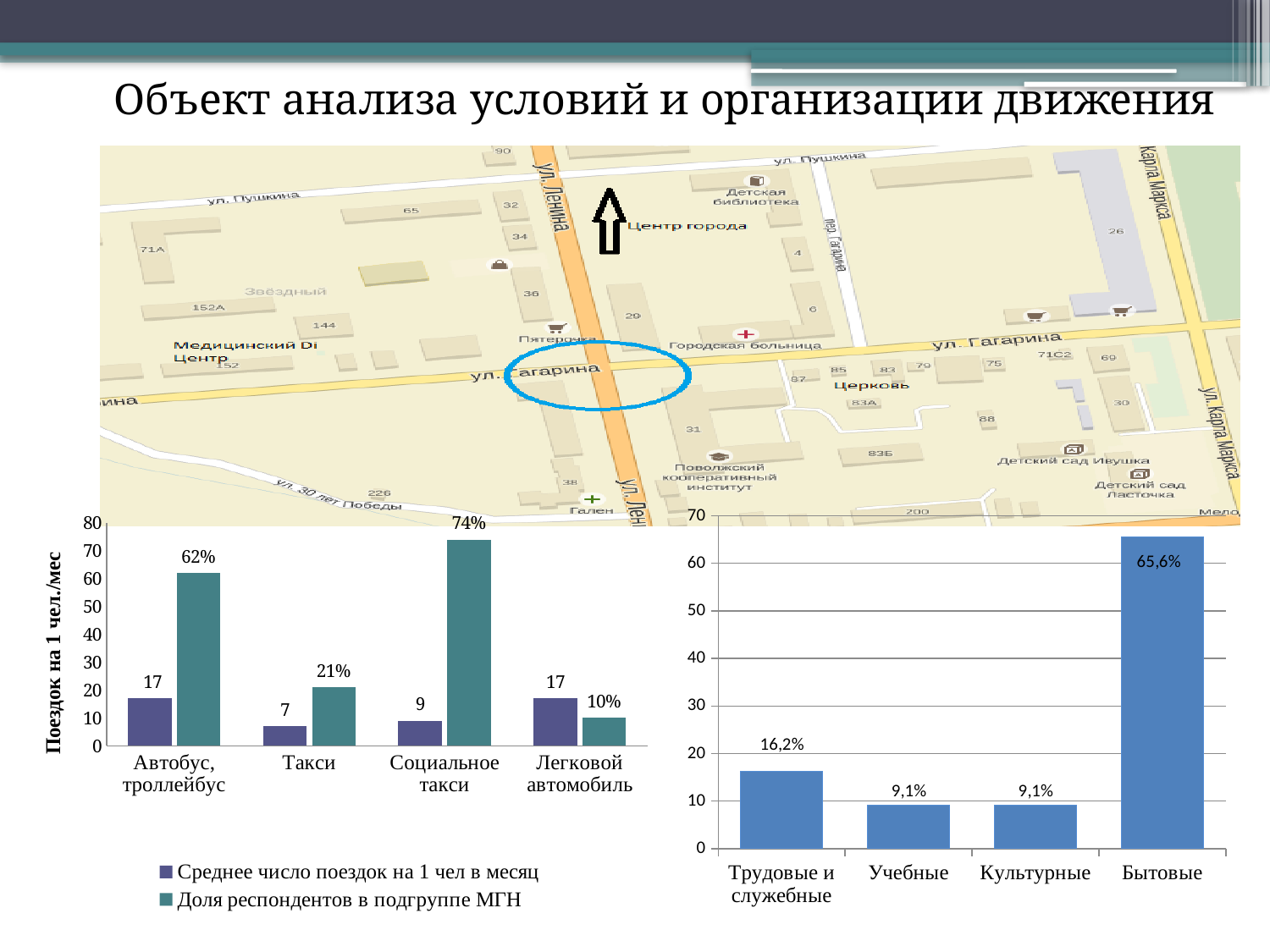
On the left chart, what is the value of 'Доля респондентов в подгруппе МГН' for Социальное такси? 74% On the left chart, what is the label of the vertical axis? Поездок на 1 чел./мес On the left chart, which category has the highest value of 'Доля респондентов в подгруппе МГН'? Социальное такси On the left chart, which category has the lowest value of 'Среднее число поездок на 1 чел в месяц'? Такси On the right chart, what is the difference between the values for Бытовые and Трудовые и служебные? 49,4% What kind of chart is the right chart? Bar chart On the left chart, how many series does the legend list? 2 On the right chart, how many categories are shown on the x axis? 4 On the left chart, what is the difference between the 'Доля респондентов в подгруппе МГН' values for Автобус, троллейбус and Легковой автомобиль? 52% On the right chart, which category has the highest value? Бытовые On the right chart, what is the value for Бытовые? 65,6% On the left chart, what is the value of 'Среднее число поездок на 1 чел в месяц' for Такси? 7